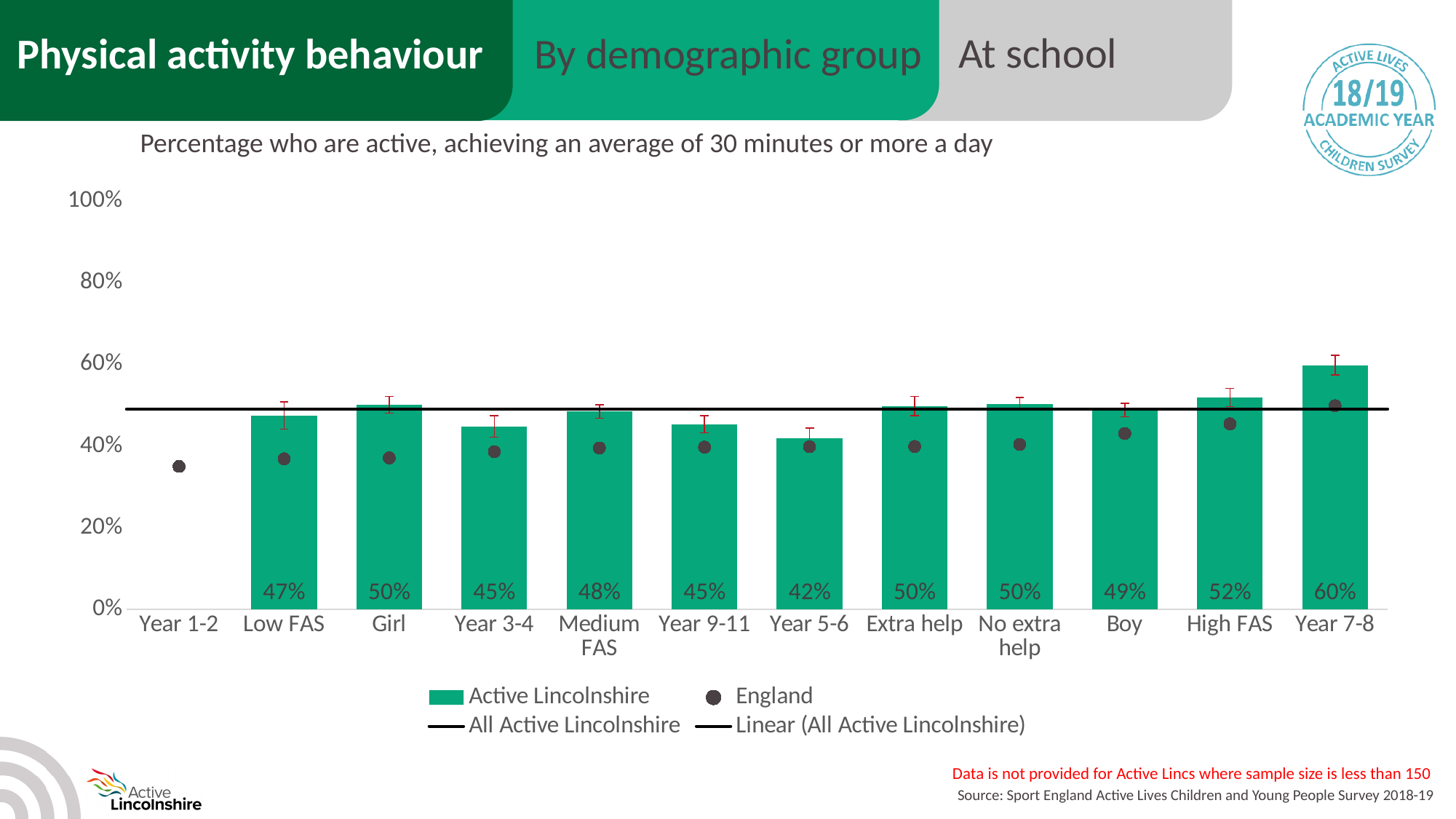
What is the difference in percentage points between the Active Lincolnshire values for Year 7-8 and Year 5-6? 18 What is the Active Lincolnshire value for Low FAS? 47% What is the difference in percentage points between the Active Lincolnshire values for High FAS and Low FAS? 5 How many categories are shown on the x axis? 12 Is the England value for Year 1-2 greater or less than 40%? less Which category has the highest Active Lincolnshire bar? Year 7-8 What type of chart is shown on the slide? Bar chart Which category has the lowest Active Lincolnshire bar? Year 5-6 What is the Active Lincolnshire value for Year 5-6? 42% What is the Active Lincolnshire value for Year 7-8? 60% How many entries does the legend list? 4 Which has the larger Active Lincolnshire value, Girl or Boy? Girl